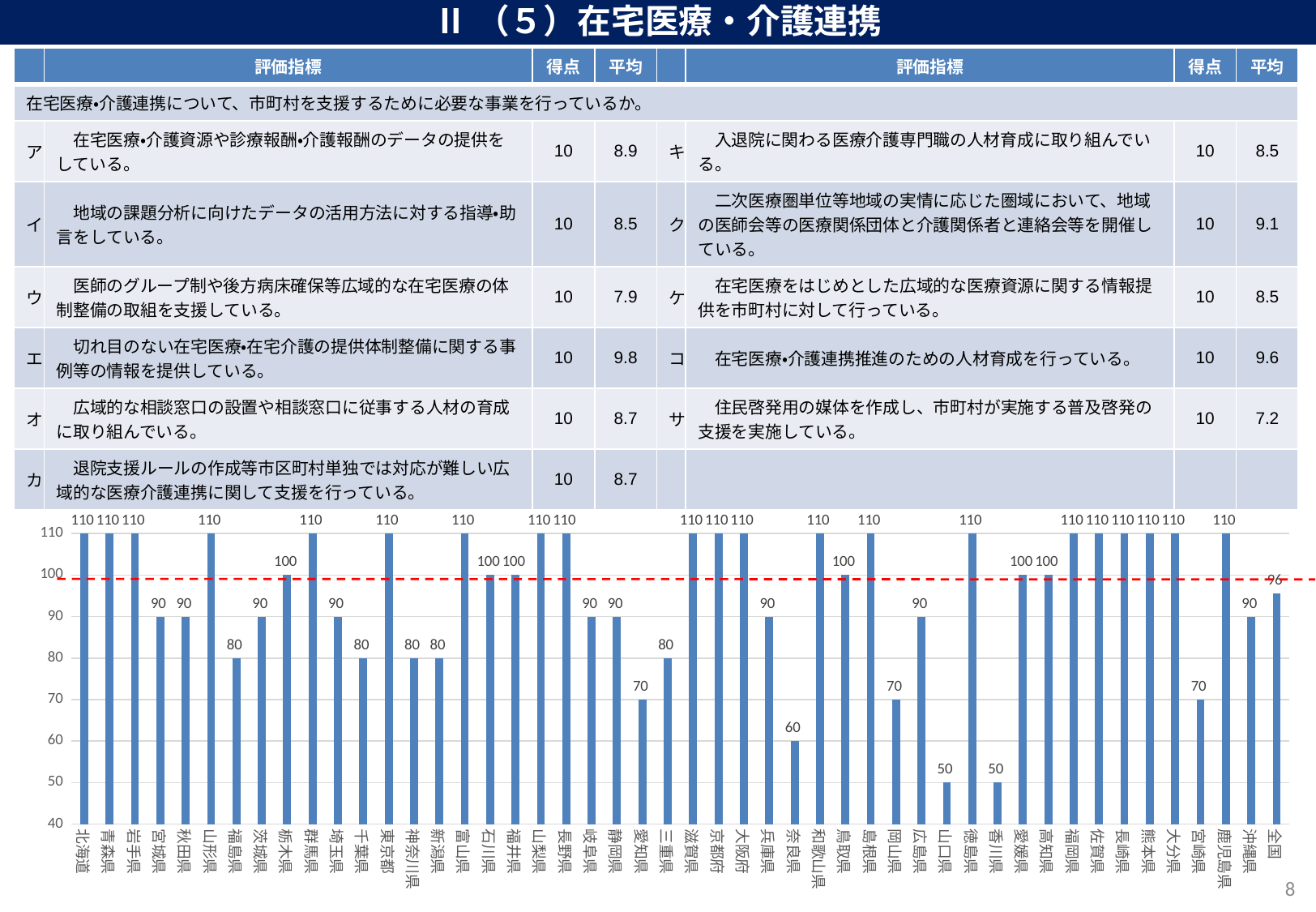
Which categories have the lowest value in the bar chart? 山口県 and 香川県 Which is larger, the value for 岡山県 or the value for 広島県? 広島県 What is the difference between the values for 全国 and 沖縄県? 6 What is the value for 栃木県 in the bar chart? 100 What is the value for 奈良県 in the bar chart? 60 Which is larger, the value for 愛知県 or the value for 三重県? 三重県 What kind of chart is shown at the bottom of the slide? bar chart What is the difference between the values for 北海道 and 奈良県? 50 How many categories are shown on the x axis of the bar chart? 48 What is the value for 宮崎県 in the bar chart? 70 What is the value for 全国 in the bar chart? 96